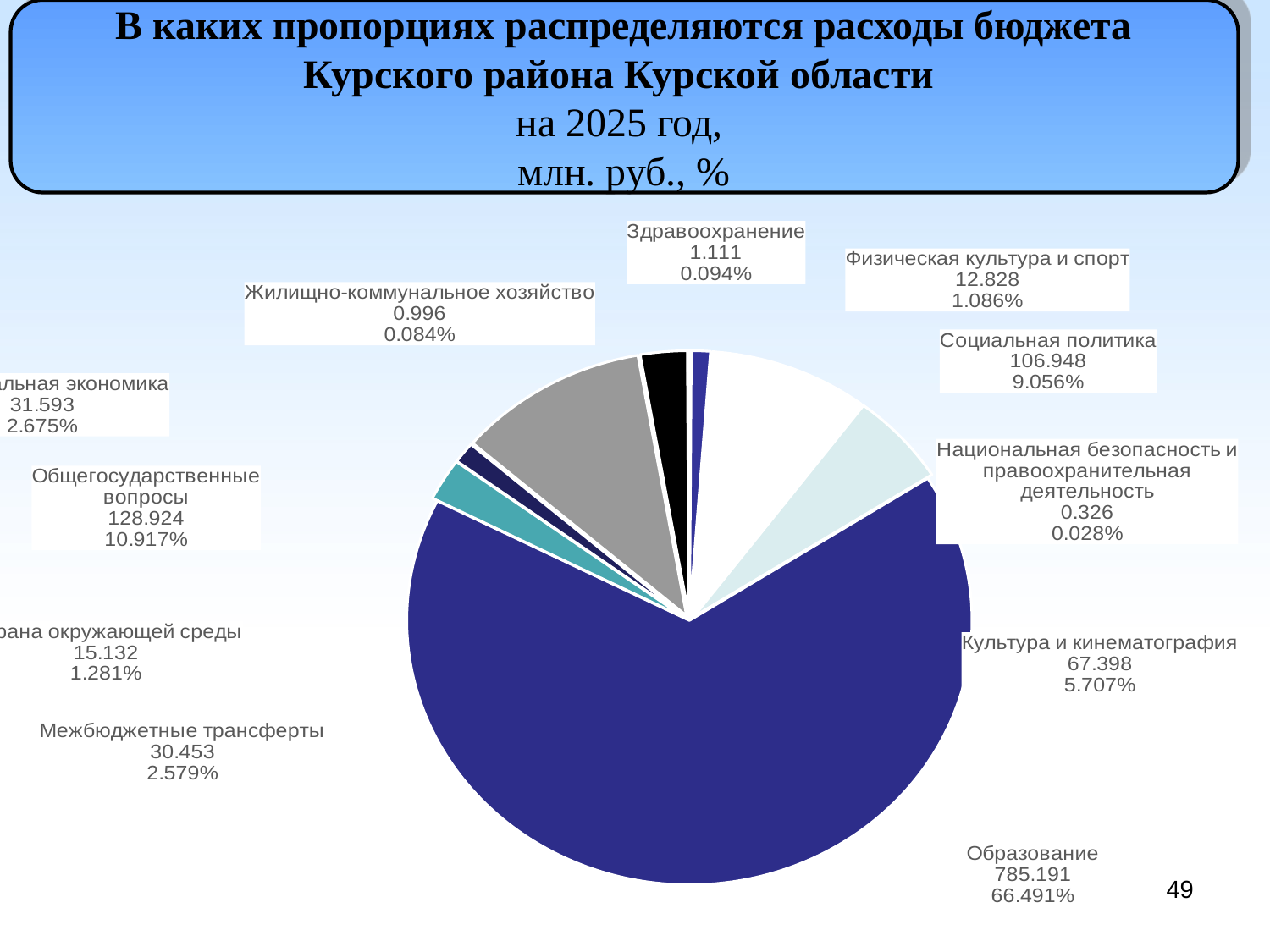
What percentage is shown for Здравоохранение? 0.094% What is the value for Культура и кинематография? 67.398 What share of the pie does Образование represent? 66.491% Which category has the largest slice of the pie? Образование What is the value for Образование? 785.191 Which is larger, Физическая культура и спорт or Межбюджетные трансферты? Межбюджетные трансферты What is the value for Социальная политика? 106.948 Which category has the smallest value? Национальная безопасность и правоохранительная деятельность What percentage is shown for Общегосударственные вопросы? 10.917% What kind of chart is shown on the slide? pie chart What is the difference between the values for Общегосударственные вопросы and Социальная политика? 21.976 How many categories are shown in the pie chart? 11